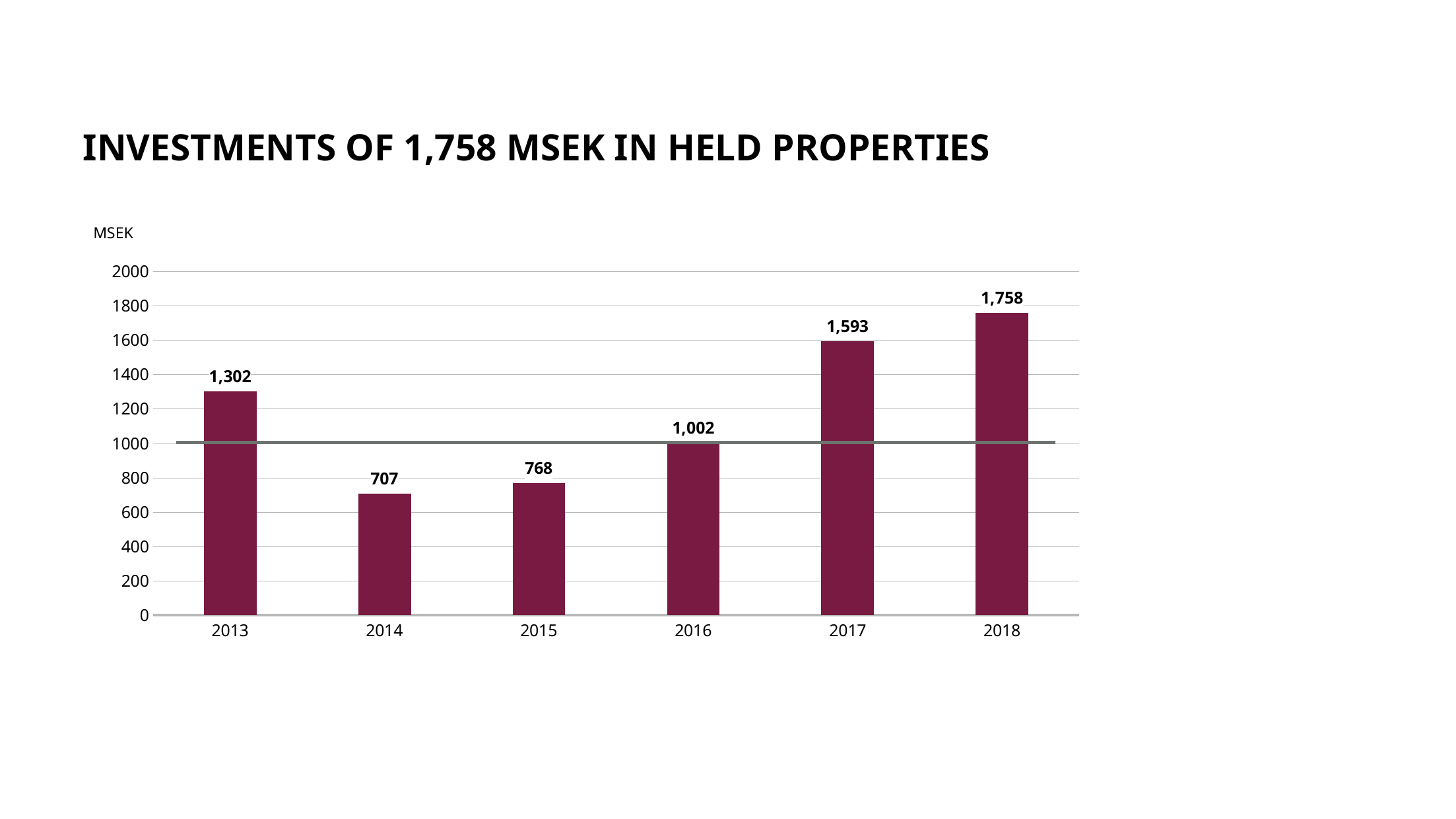
Is the value for 2017 greater or less than 1400? greater Which year has the lowest value? 2014 What is the value for 2018? 1,758 What kind of chart is shown on the slide? bar chart What unit is shown on the y axis label? MSEK What is the value for 2016? 1,002 What is the difference between the values for 2013 and 2014? 595 What is the value for 2014? 707 What is the difference between the values for 2018 and 2017? 165 Which is larger, the value for 2015 or the value for 2016? 2016 Which year has the highest value? 2018 How many years are shown on the x axis? 6